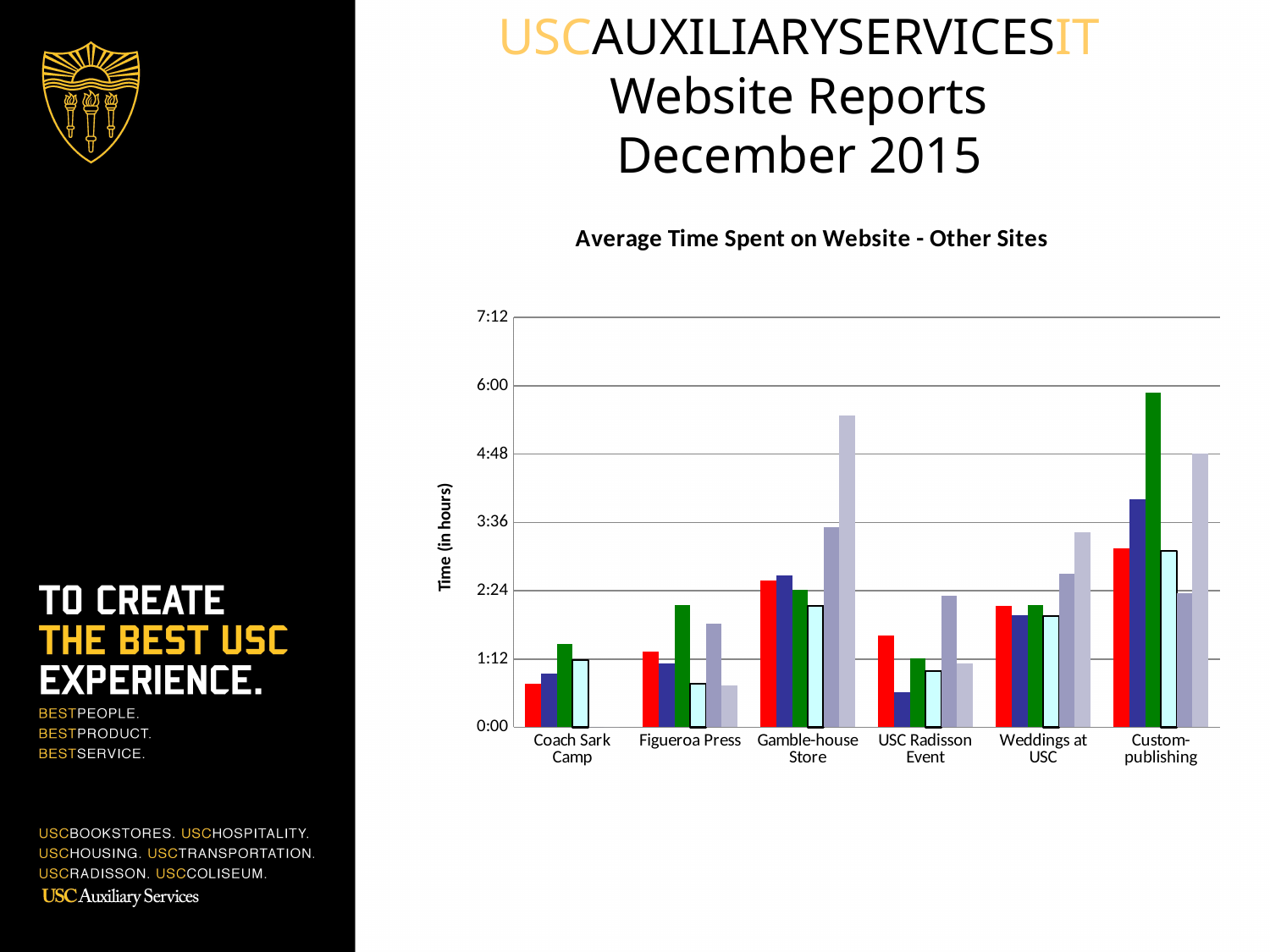
Is the value of the red bar for Coach Sark Camp greater or less than 1:12? less How many bars are plotted for each category in the chart? 6 Is the value of the green bar for Figueroa Press greater or less than 2:24? less What kind of chart is shown on the slide? Bar chart What is the title of the chart? Average Time Spent on Website - Other Sites Which category has the tallest green bar? Custom-publishing What is the label on the vertical axis of the chart? Time (in hours) Is the value of the tallest bar for Gamble-house Store greater or less than 4:48? greater How many categories are shown along the x axis of the chart? 6 Which category has the shortest red bar? Coach Sark Camp